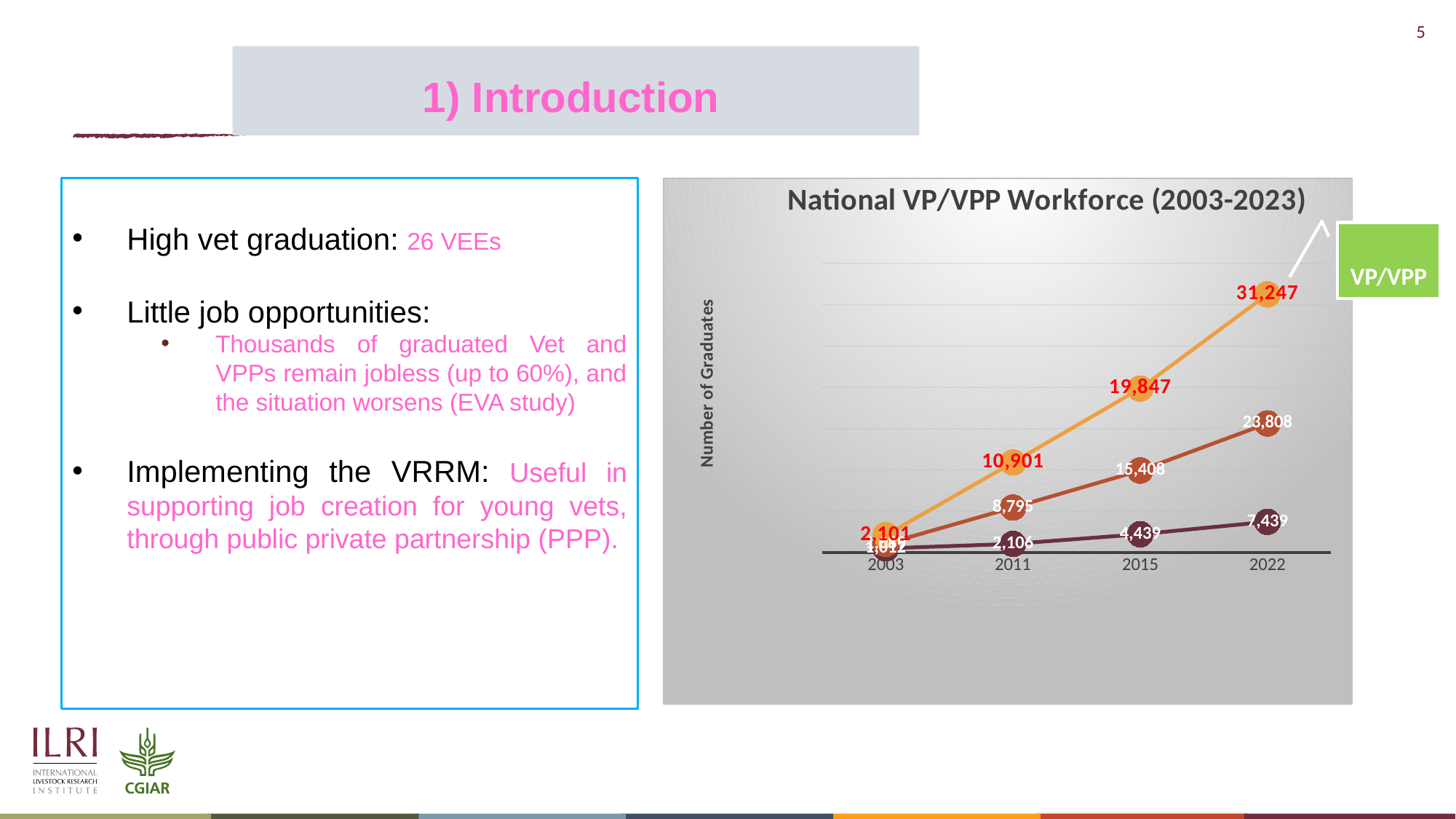
What is the value of the VP/VPP line in 2022? 31,247 What type of chart is shown on the slide? line chart How many years are shown on the x axis? 4 What is the value of the VP/VPP line in 2011? 10,901 What is the difference between the VP/VPP values in 2022 and 2015? 11,400 What is the title of the chart? National VP/VPP Workforce (2003-2023) In which year does the VP/VPP line reach its highest value? 2022 What is the value of the dark red line in 2022? 23,808 Does the VP/VPP line rise or fall from 2003 to 2022? rise What is the value of the VP/VPP line in 2003? 2,101 What is the value of the VP/VPP line in 2015? 19,847 What is the value of the dark purple line in 2015? 4,439